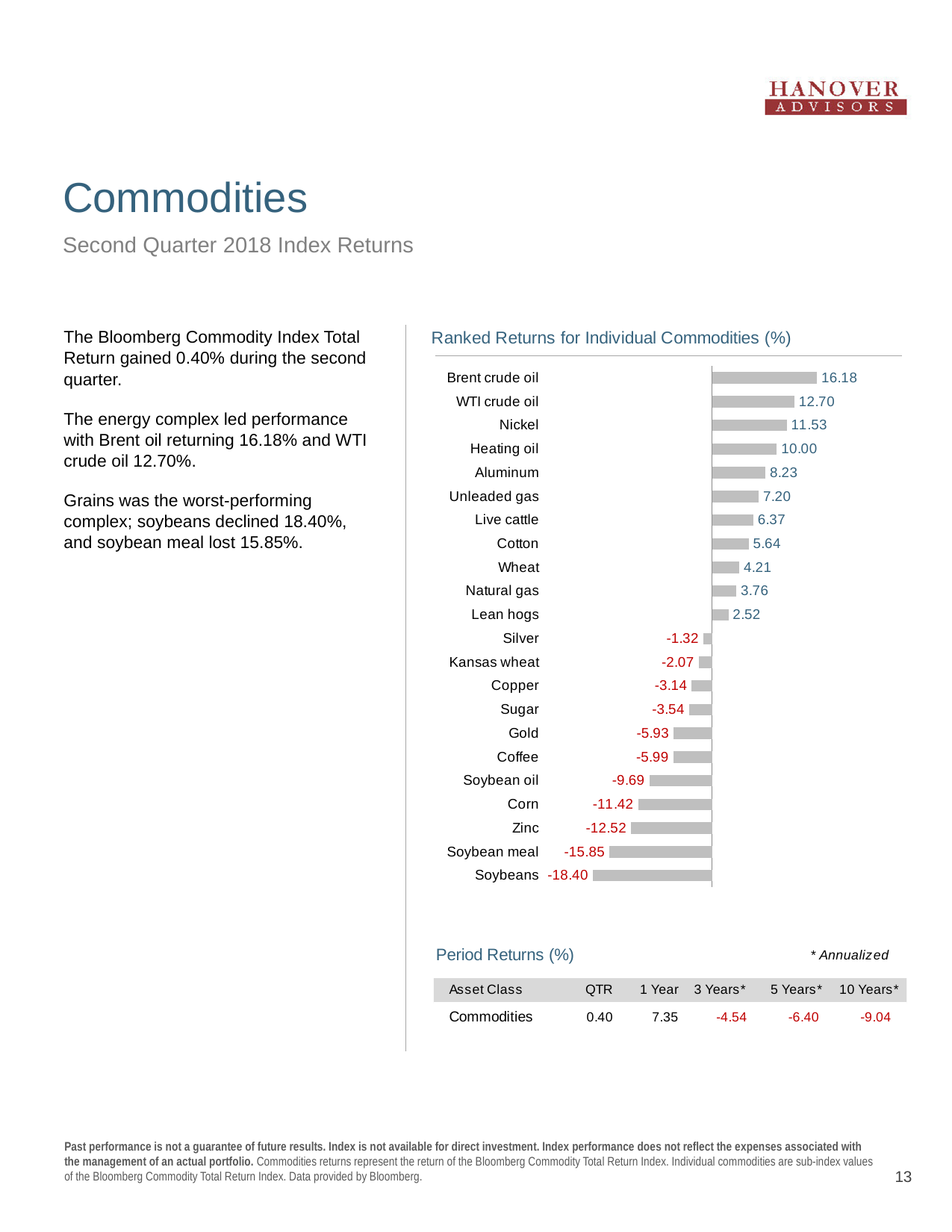
What is the value for Natural gas in the Ranked Returns for Individual Commodities chart? 3.76 Which has the higher return in the Ranked Returns for Individual Commodities chart, Nickel or Heating oil? Nickel What is the difference between the returns for Brent crude oil and WTI crude oil in the Ranked Returns for Individual Commodities chart? 3.48 What kind of chart is the Ranked Returns for Individual Commodities chart? Bar chart Which commodity has the highest return in the Ranked Returns for Individual Commodities chart? Brent crude oil What is the value for Brent crude oil in the Ranked Returns for Individual Commodities chart? 16.18 How many commodities are shown in the Ranked Returns for Individual Commodities chart? 22 Which has the lower return in the Ranked Returns for Individual Commodities chart, Gold or Soybean oil? Soybean oil What is the value for Soybean meal in the Ranked Returns for Individual Commodities chart? -15.85 Which commodity has the lowest return in the Ranked Returns for Individual Commodities chart? Soybeans What is the difference between the returns for Corn and Zinc in the Ranked Returns for Individual Commodities chart? 1.10 What is the title of the chart on the slide? Ranked Returns for Individual Commodities (%)